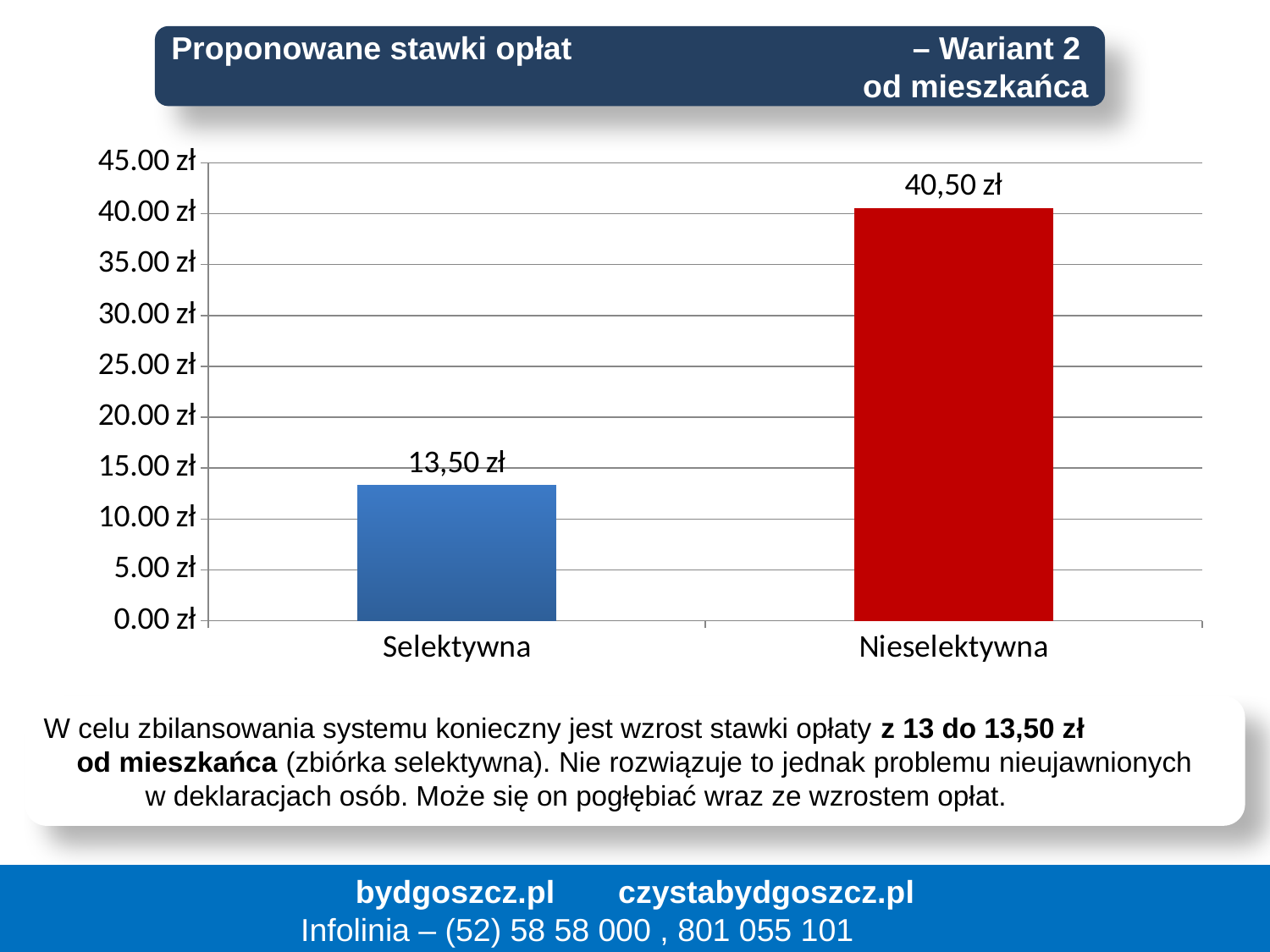
Which is larger, the value for Selektywna or the value for Nieselektywna? Nieselektywna How many categories are shown on the chart? 2 Is the value for Selektywna greater or less than 15.00 zł? less What is the highest value shown on the vertical axis? 45.00 zł What is the value for Selektywna? 13,50 zł What kind of chart is shown on the slide? bar chart Which category has the lowest value? Selektywna What colour is the bar for Nieselektywna? red Which category has the highest value? Nieselektywna What is the difference between the values for Nieselektywna and Selektywna? 27,00 zł Is the value for Nieselektywna greater or less than 40.00 zł? greater What is the value for Nieselektywna? 40,50 zł